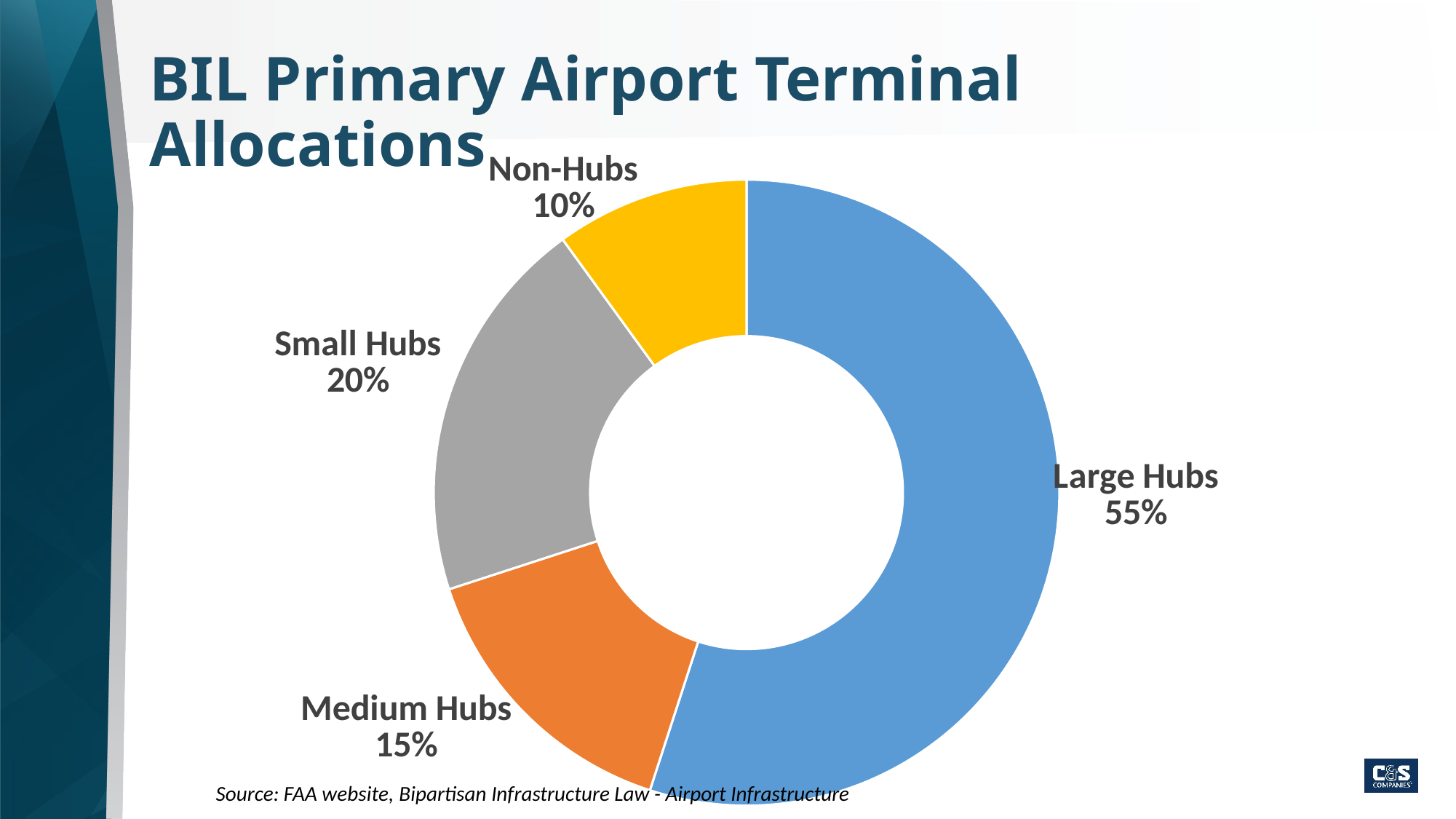
Which category receives the largest share of the allocations? Large Hubs How many categories are shown in the chart? 4 Which category receives the smallest share of the allocations? Non-Hubs What is the difference in percentage points between the Small Hubs and Medium Hubs shares? 5 What percentage is allocated to Non-Hubs? 10% What colour is the Small Hubs slice? Gray What share of the BIL primary airport terminal allocations goes to Large Hubs? 55% What percentage is allocated to Medium Hubs? 15% What kind of chart is shown on the slide? Doughnut (pie) chart What is the difference in percentage points between the Large Hubs and Small Hubs shares? 35 Which receives a larger share, Medium Hubs or Non-Hubs? Medium Hubs What percentage is allocated to Small Hubs? 20%